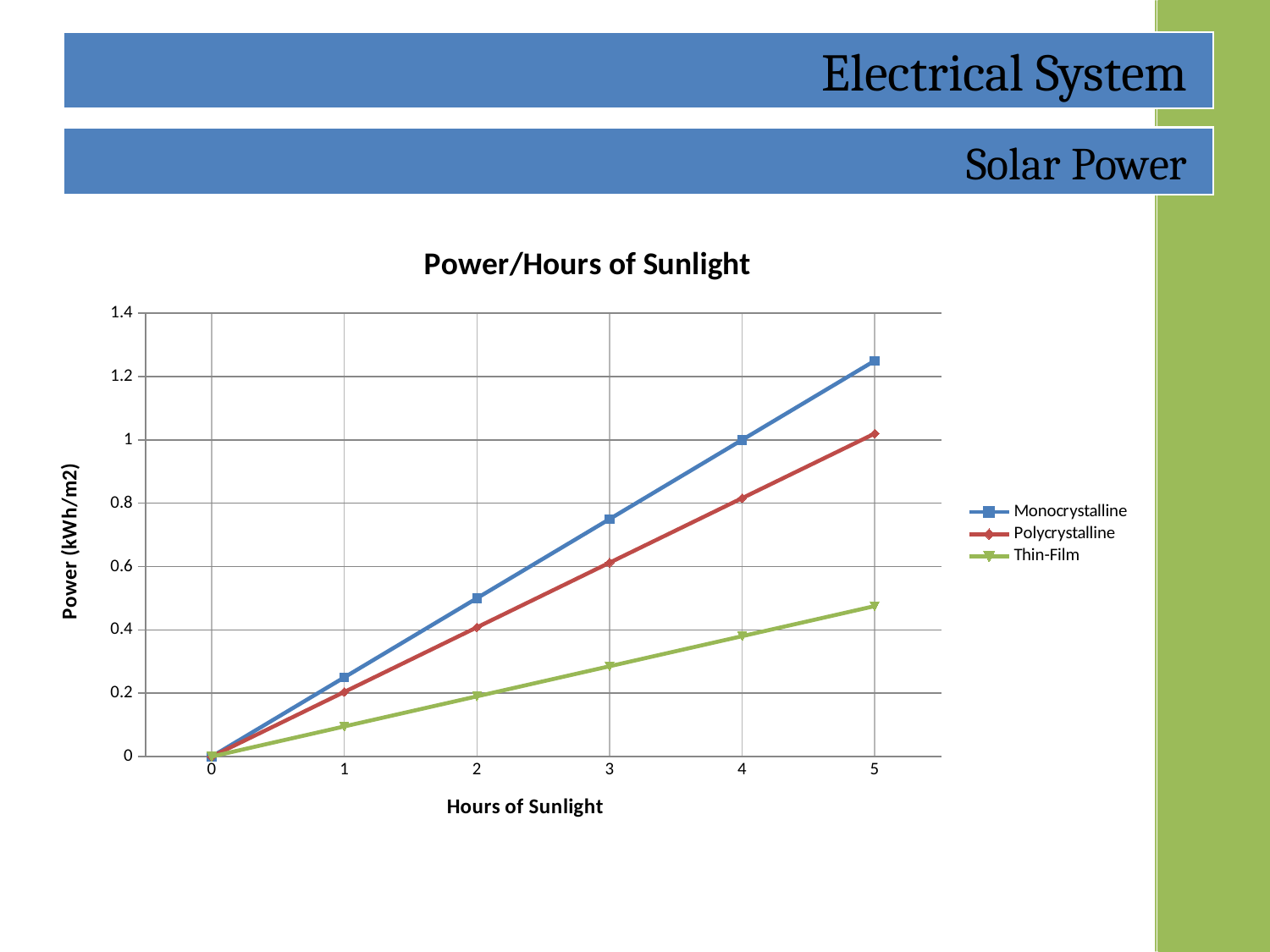
What kind of chart is shown on the slide? line chart Which series has the highest value at 5 hours of sunlight? Monocrystalline Is the Monocrystalline value at 5 hours of sunlight greater or less than 1.2? greater What is the Monocrystalline value at 4 hours of sunlight? 1 How many series does the legend list? 3 What is the title of the chart? Power/Hours of Sunlight At 5 hours of sunlight, which is larger: Polycrystalline or Thin-Film? Polycrystalline Is the Thin-Film value at 5 hours of sunlight greater or less than 0.6? less Which series has the lowest value at 3 hours of sunlight? Thin-Film What is the Thin-Film value at 0 hours of sunlight? 0 What is the label of the y axis? Power (kWh/m2) Do the Polycrystalline values rise or fall as hours of sunlight increase? rise